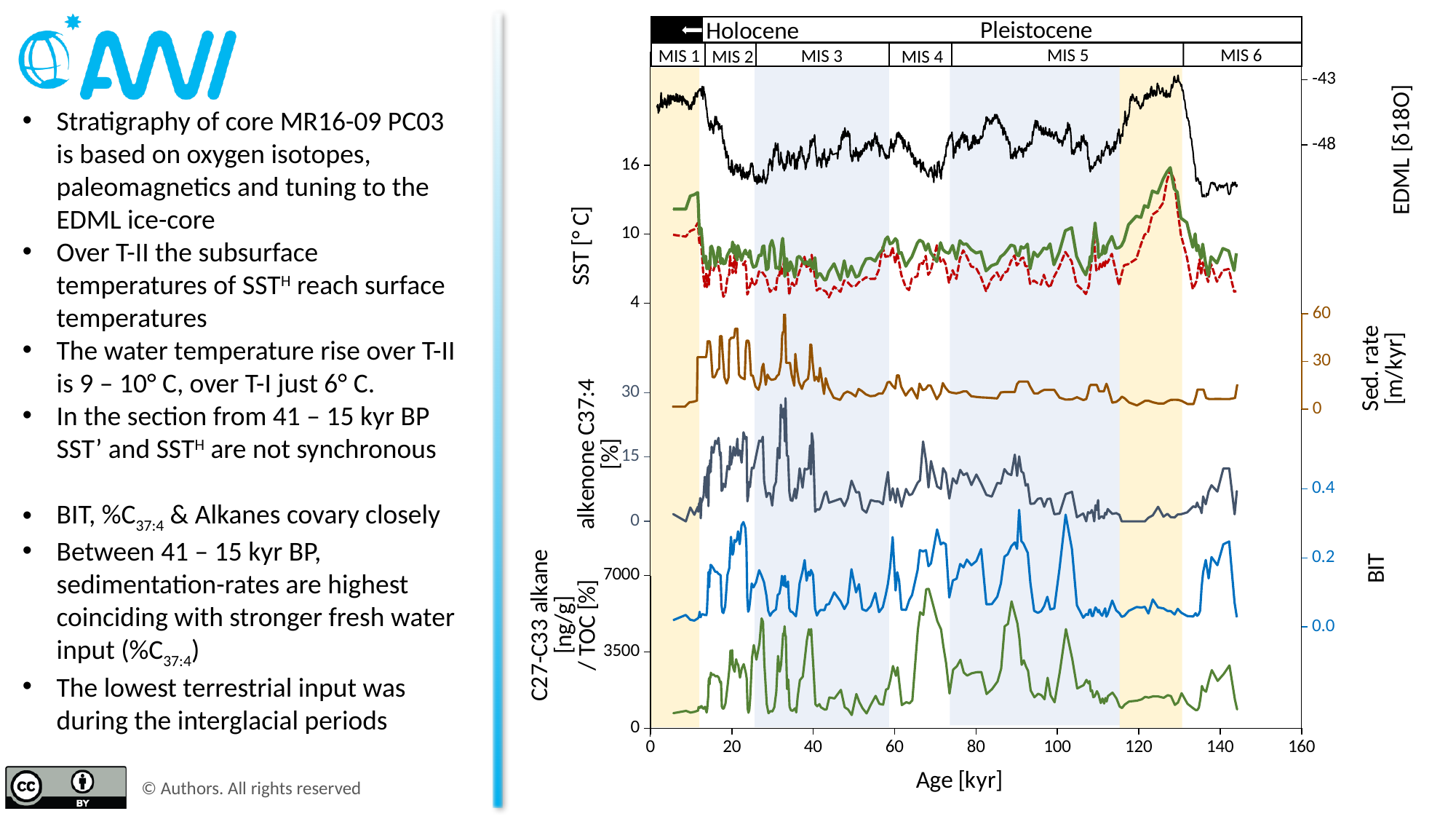
Is the alkenone C37:4 peak near 33 kyr greater or less than 15%? greater What is the highest value shown on the x axis of the chart? 160 Is the sedimentation rate larger at 33 kyr or at 100 kyr? 33 kyr Is the peak sedimentation rate (brown line) near 33 kyr greater or less than 30 m/kyr? greater Is the red dashed SST value at 50 kyr greater or less than 10 °C? less What kind of chart is shown on the slide? line chart How many marine isotope stages (MIS) are labelled along the top of the chart? 6 What is the label of the x axis of the chart? Age [kyr] Is the BIT value (blue line) larger at 20 kyr or at 120 kyr? 20 kyr How many epochs are named in the header bar above the chart? 2